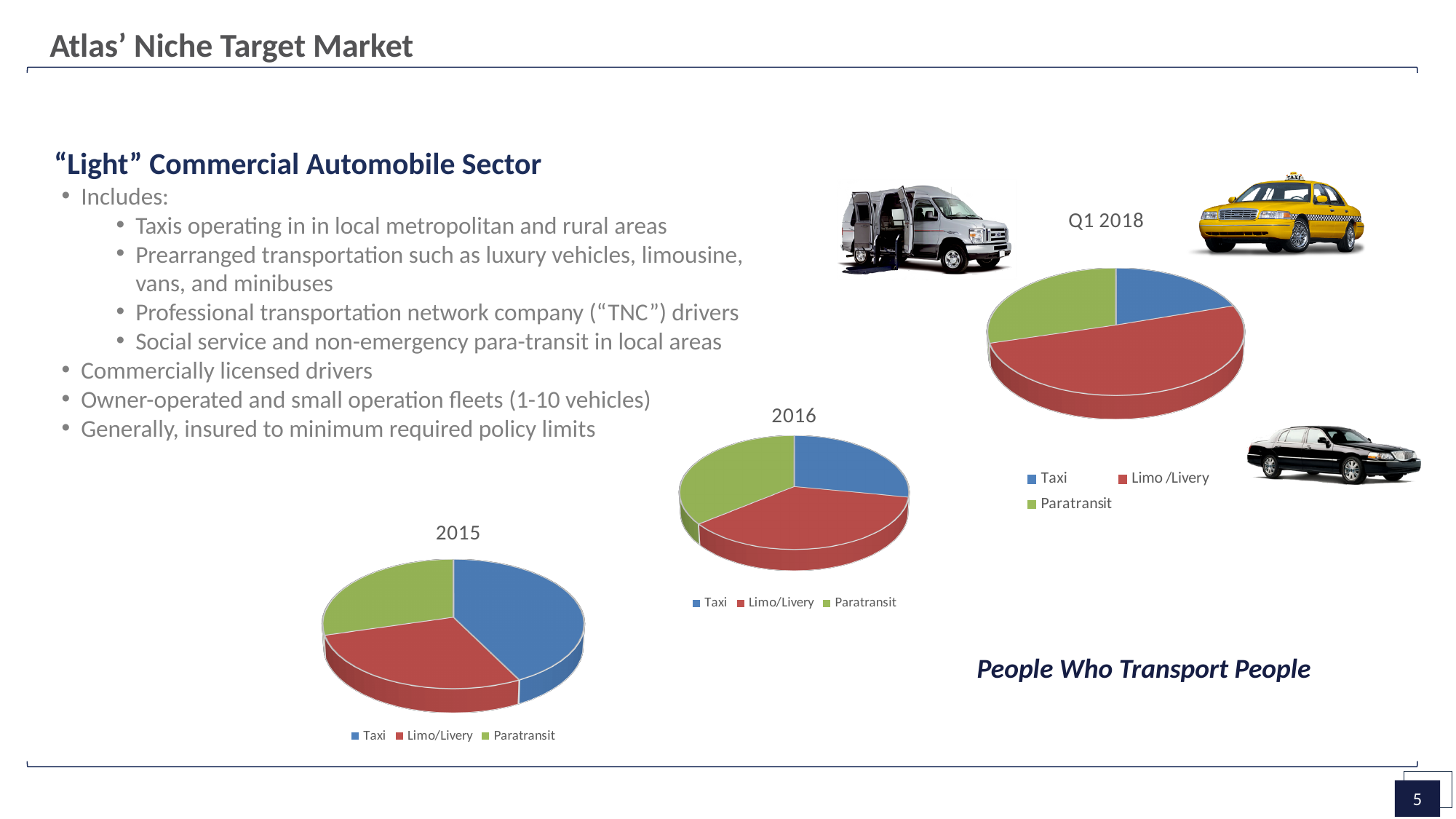
What kind of chart is the 2015 chart? pie chart What is the title of the chart at the bottom left of the slide? 2015 In the Q1 2018 chart, which slice is larger, Limo /Livery or Paratransit? Limo /Livery How many slices does the 2016 pie chart have? 3 How many charts are shown on the slide? 3 In the 2016 chart, which slice is larger, Limo/Livery or Taxi? Limo/Livery Which colour represents Paratransit in the pie charts? green In the Q1 2018 chart, which category has the largest slice? Limo /Livery How many entries does the legend of the Q1 2018 chart list? 3 What kind of chart is the Q1 2018 chart? pie chart